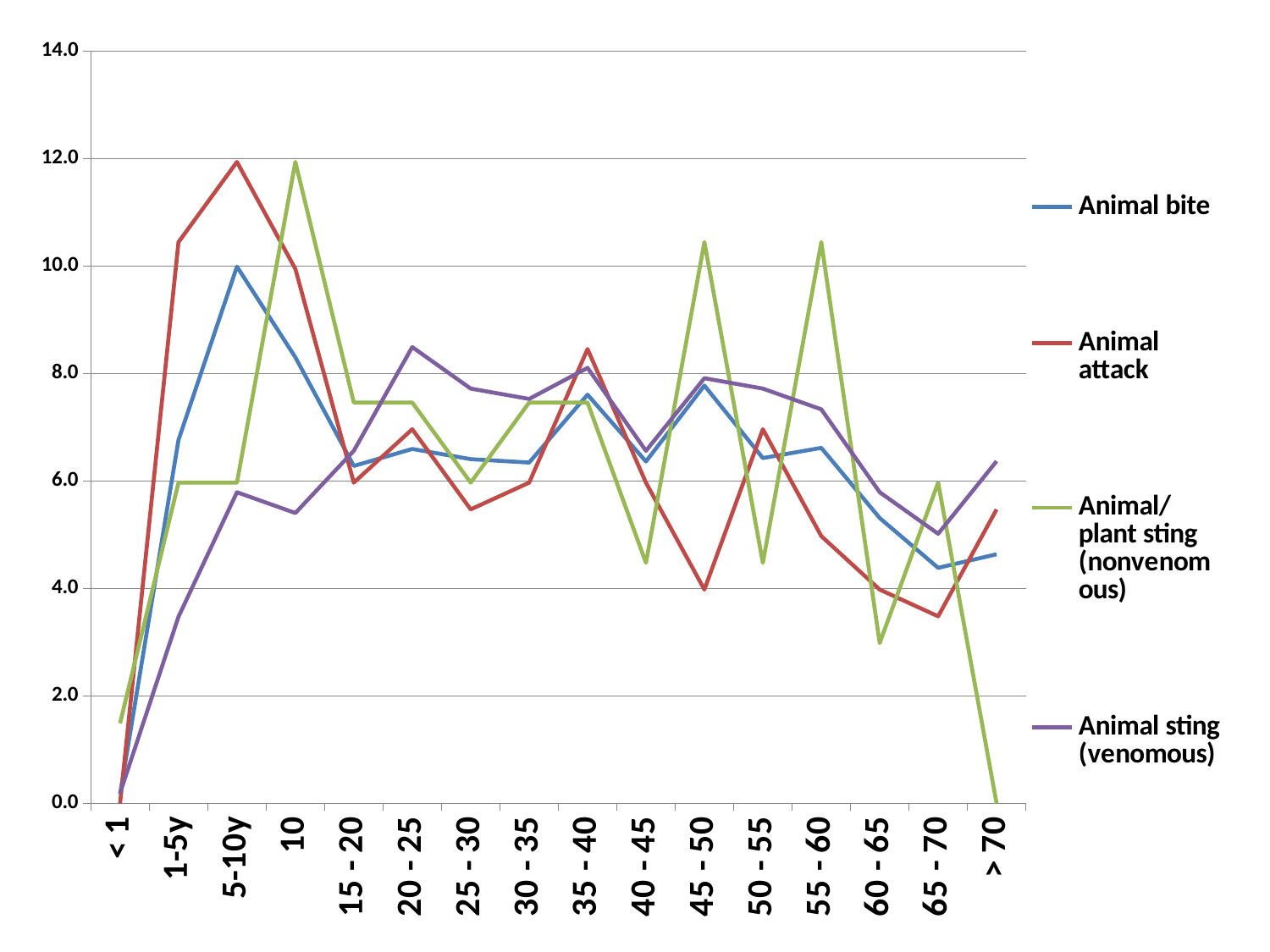
What is the value of the Animal/plant sting (nonvenomous) series for the > 70 category? 0.0 In which age category does the Animal bite series reach its highest value? 5-10y In which age category is the Animal/plant sting (nonvenomous) series at its lowest? > 70 Is the value for Animal sting (venomous) at 1-5y greater or less than 4.0? less Is the value for Animal bite at 65 - 70 greater or less than 6.0? less In which age category does the Animal attack series reach its highest value? 5-10y What kind of chart is shown on the slide? line chart How many age categories are shown on the x axis? 16 At 45 - 50, which series has the larger value: Animal/plant sting (nonvenomous) or Animal attack? Animal/plant sting (nonvenomous) Is the value for Animal attack at 5-10y greater or less than 10.0? greater Which colour is used for the Animal bite series? blue How many series does the legend list? 4